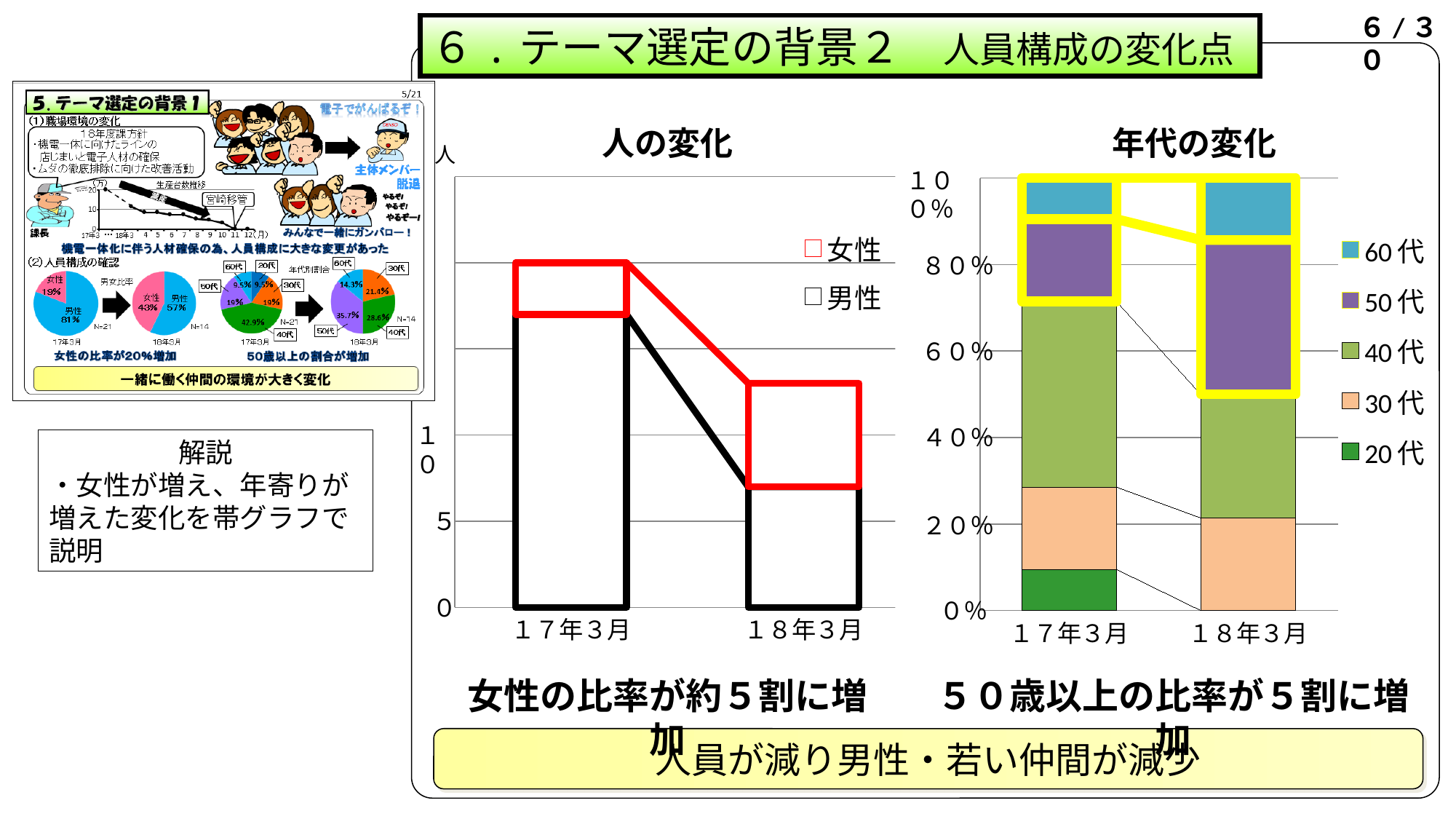
Which legend entries are listed for the "年代の変化" chart? 60代, 50代, 40代, 30代, 20代 In the "人の変化" chart, is the value for 男性 in 18年3月 greater or less than 10? less In the "年代の変化" chart, is the share for 50代 in 18年3月 greater or less than 20%? greater In the "年代の変化" chart, is the share for 20代 in 17年3月 greater or less than 20%? less How many categories are shown on the x axis of the "年代の変化" chart? 2 In the "人の変化" chart, does the 男性 value rise or fall from 17年3月 to 18年3月? fall What kind of chart is the "人の変化" chart? bar chart In the "年代の変化" chart, is the 40代 segment larger in 17年3月 or in 18年3月? 17年3月 How many series does the legend of the "年代の変化" chart list? 5 How many series does the legend of the "人の変化" chart list? 2 In the "人の変化" chart, which category has the taller total bar, 17年3月 or 18年3月? 17年3月